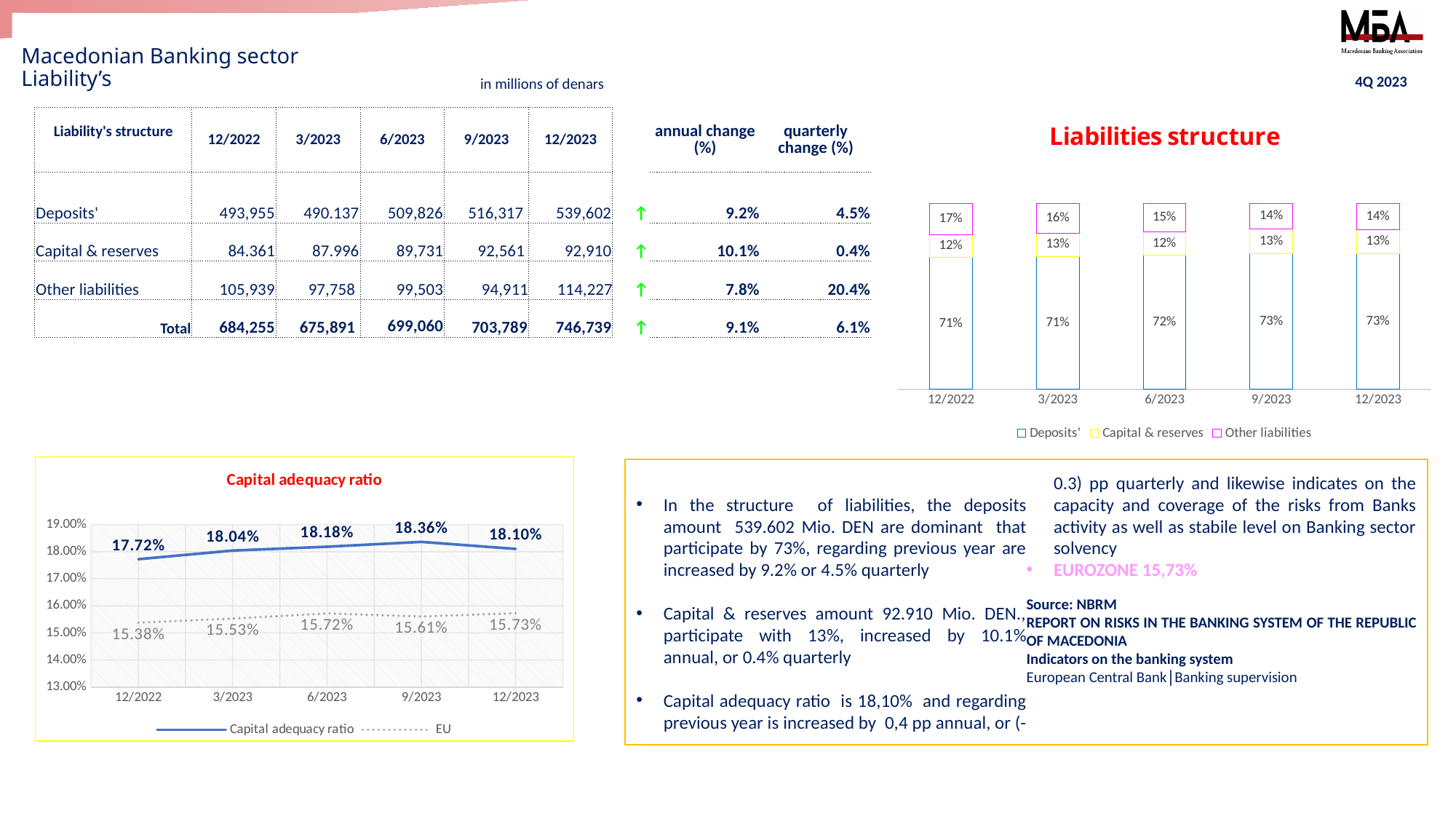
In the Liabilities structure chart, what share do Deposits' have in 12/2023? 73% What type of chart is the Capital adequacy ratio chart? line chart In the Liabilities structure chart, what share do Other liabilities have in 12/2022? 17% In the Liabilities structure chart, how many periods are shown on the x axis? 5 In the Liabilities structure chart, what share do Capital & reserves have in 3/2023? 13% In the Liabilities structure chart, how many series does the legend list? 3 In the Liabilities structure chart, does the Deposits' share rise or fall from 12/2022 to 12/2023? rise In the Capital adequacy ratio chart, what is the Capital adequacy ratio in 9/2023? 18.36% In the Capital adequacy ratio chart, in which period is the Capital adequacy ratio highest? 9/2023 In the Capital adequacy ratio chart, what is the difference between the Capital adequacy ratio and the EU value in 12/2023? 2.37 percentage points In the Liabilities structure chart, what is the difference between the Other liabilities share in 12/2022 and in 12/2023? 3 percentage points In the Capital adequacy ratio chart, what is the EU value in 12/2022? 15.38%